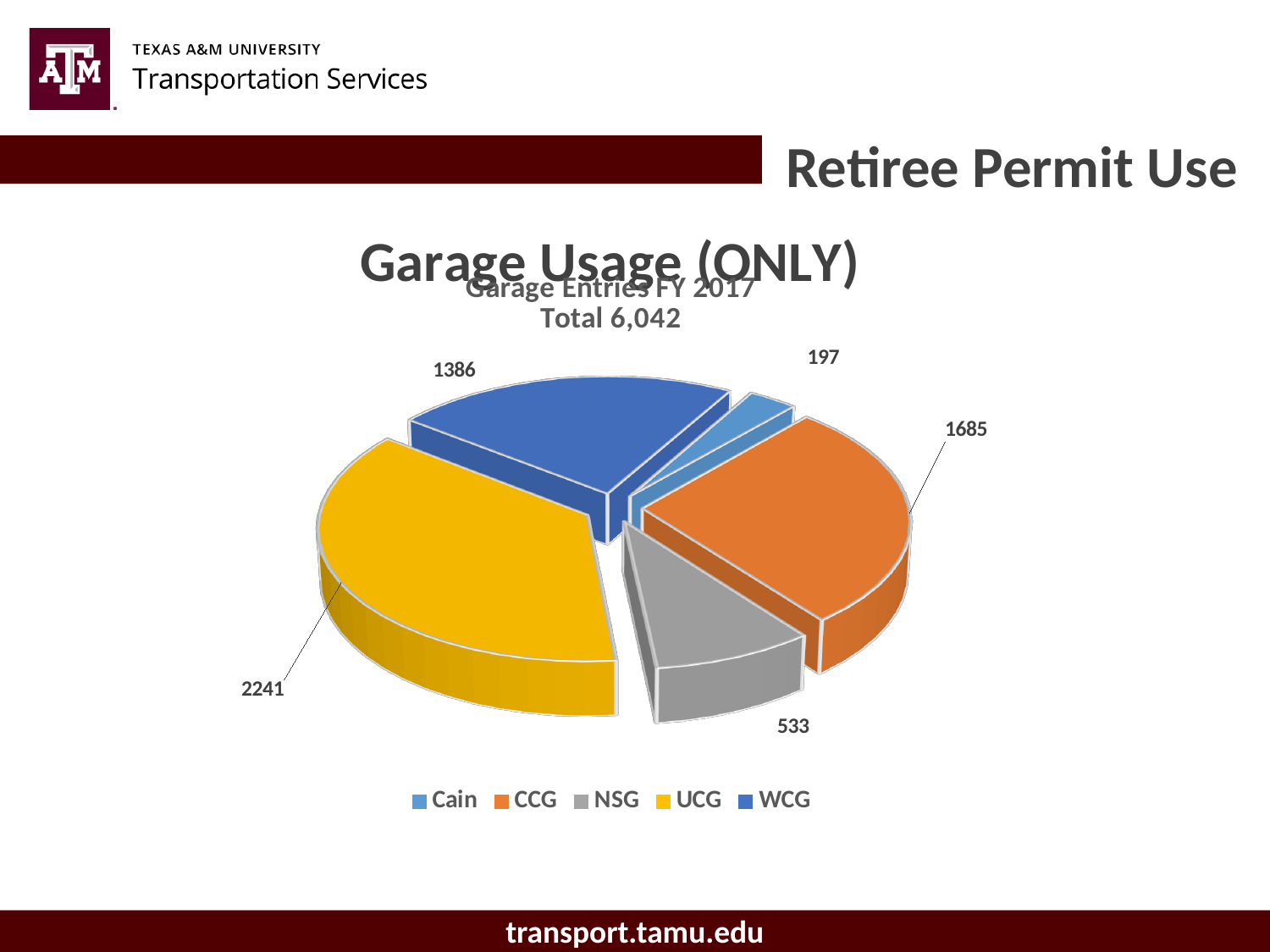
How many garage entries are shown for CCG? 1685 How many garages (slices) does the pie chart show? 5 How many entries does the legend of the pie chart list? 5 How many garage entries are shown for UCG? 2241 How many garage entries are shown for Cain? 197 Which garage has the highest number of entries? UCG What total number of garage entries is stated in the chart title? 6,042 How many garage entries are shown for WCG? 1386 What kind of chart is shown on the slide? pie chart How many garage entries are shown for NSG? 533 What is the difference between the entries for UCG and CCG? 556 Which garage has the lowest number of entries? Cain